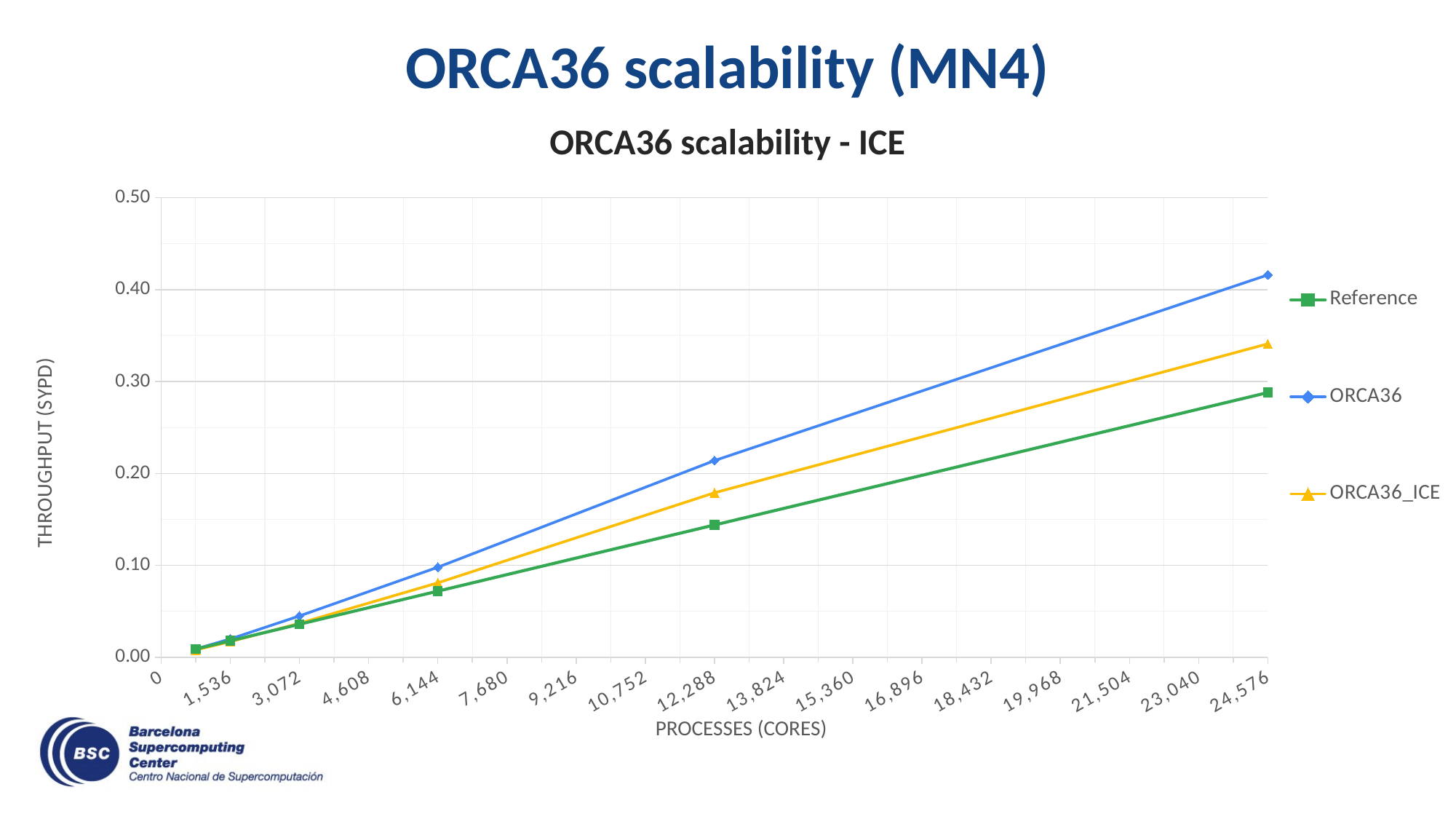
What is the label of the y axis? THROUGHPUT (SYPD) What is the title of the chart? ORCA36 scalability - ICE Is the throughput of ORCA36_ICE at 24,576 processes greater or less than 0.30? greater Is the throughput of ORCA36_ICE at 12,288 processes greater or less than 0.20? less How many series does the legend list? 3 Which series has the highest throughput at 24,576 processes? ORCA36 Is the throughput of Reference at 12,288 processes greater or less than 0.20? less What kind of chart is shown on the slide? line chart Which series has the lowest throughput at 24,576 processes? Reference At 12,288 processes, which has the higher throughput: ORCA36_ICE or Reference? ORCA36_ICE Does the throughput of the ORCA36 series rise or fall as the number of processes increases? rise